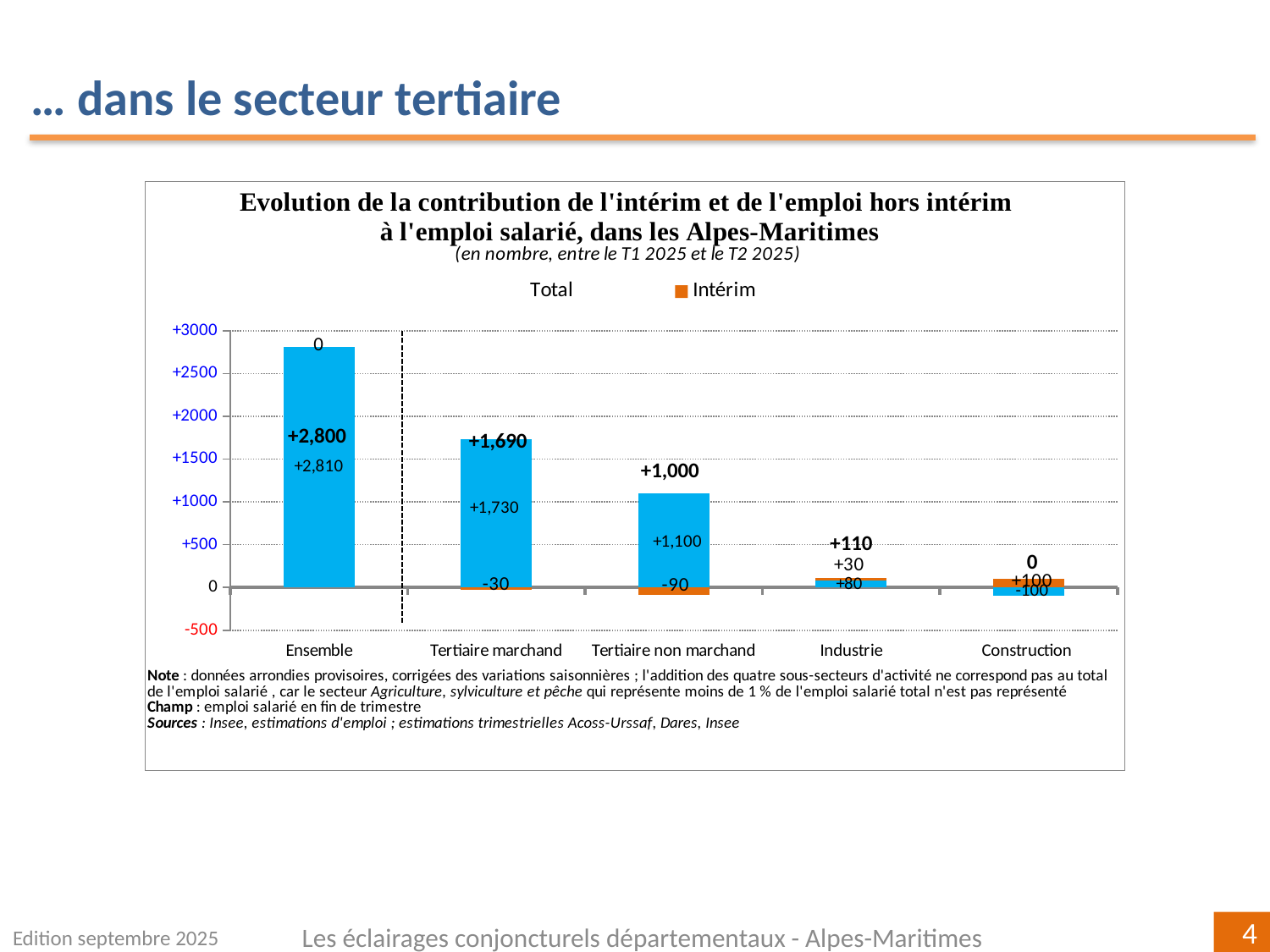
How many sector categories are shown along the x axis? 5 What is the Intérim value for Tertiaire non marchand? -90 Which category has the highest total? Ensemble What is the difference between the totals for Tertiaire marchand (+1,690) and Tertiaire non marchand (+1,000)? 690 What kind of chart is shown on the slide? bar chart What is the total (bold label) for Industrie? +110 Which category has the lowest total? Construction What is the total (bold label) for Tertiaire marchand? +1,690 Which colour represents the Intérim series in the legend? orange Which has the larger blue bar, Tertiaire marchand or Tertiaire non marchand? Tertiaire marchand What is the value of the blue bar for Industrie? +80 What is the Intérim value for Construction? +100